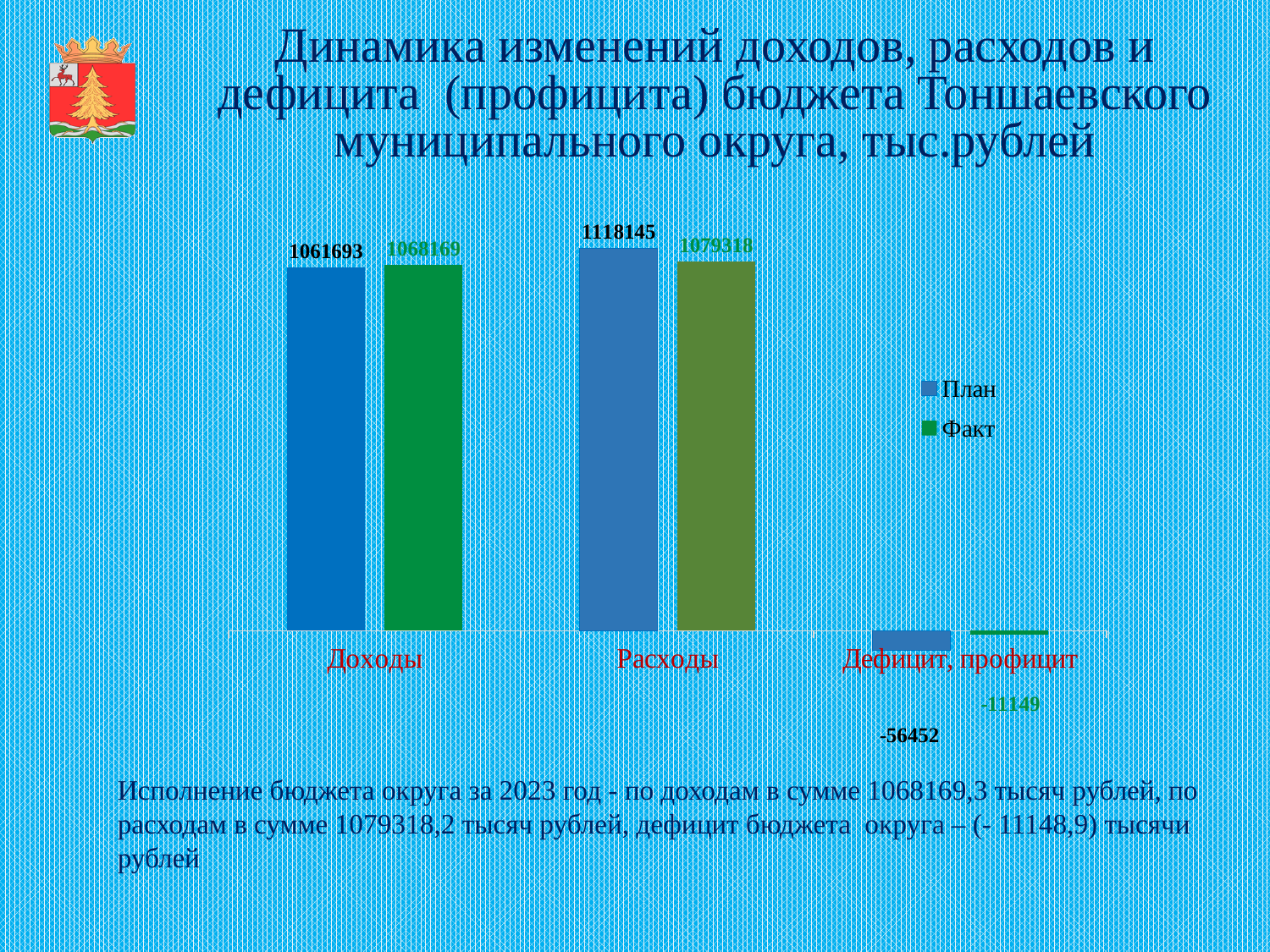
Which category has the lowest Факт value? Дефицит, профицит What is the План value for Расходы? 1118145 How many series does the legend list? 2 What is the Факт value for Расходы? 1079318 What is the difference between the План and Факт values for Расходы? 38827 What is the План value for Доходы? 1061693 Which category has the highest План value? Расходы Which is larger for Доходы, the План value or the Факт value? Факт What is the План value for Дефицит, профицит? -56452 What is the Факт value for Дефицит, профицит? -11149 What is the Факт value for Доходы? 1068169 What kind of chart is shown on the slide? Bar chart